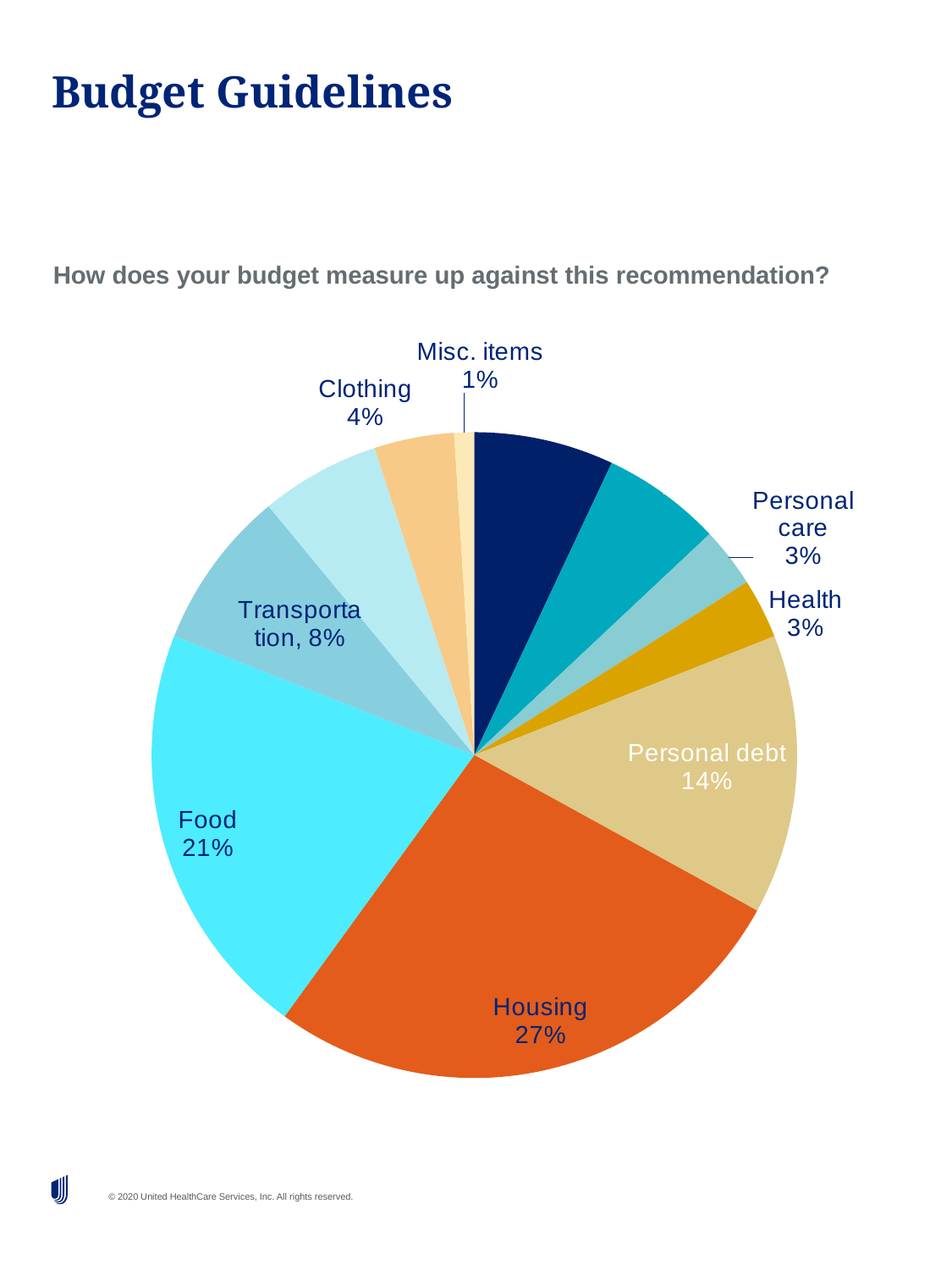
What percentage is shown for Food? 21% What colour is the Housing slice? orange What percentage is shown for Clothing? 4% Which is larger, Food or Personal debt? Food What kind of chart is shown on the slide? pie chart Which labeled category has the smallest share of the pie? Misc. items What percentage is shown for Personal debt? 14% What percentage is shown for Transportation? 8% How many percentage points larger is Housing than Food? 6% Which labeled category has the largest share of the pie? Housing What percentage is shown for Misc. items? 1% What share of the budget does Housing take? 27%